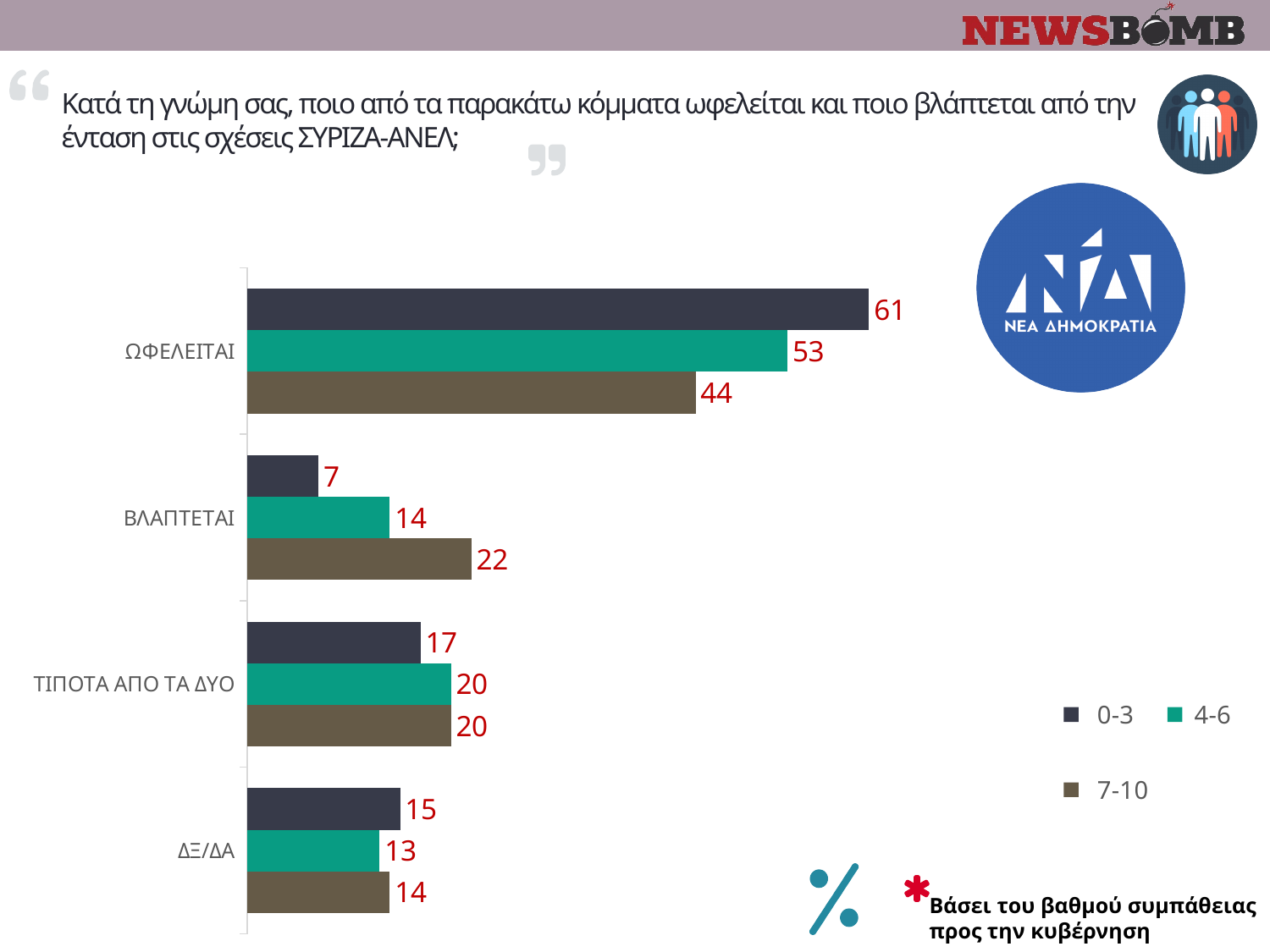
What is the value for the 7-10 series in the ΒΛΑΠΤΕΤΑΙ category? 22 In the ΒΛΑΠΤΕΤΑΙ category, which series has the larger value, 0-3 or 7-10? 7-10 What is the value for the 4-6 series in the ΔΞ/ΔΑ category? 13 Which series is shown in green in the legend? 4-6 What is the value for the 0-3 series in the ΩΦΕΛΕΙΤΑΙ category? 61 How many categories are shown on the chart? 4 How many series does the legend list? 3 What is the value for the 0-3 series in the ΤΙΠΟΤΑ ΑΠΟ ΤΑ ΔΥΟ category? 17 Which category has the highest value for the 4-6 series? ΩΦΕΛΕΙΤΑΙ What is the difference between the 0-3 and 7-10 values in the ΩΦΕΛΕΙΤΑΙ category? 17 Which category has the lowest value for the 0-3 series? ΒΛΑΠΤΕΤΑΙ What kind of chart is shown on the slide? bar chart